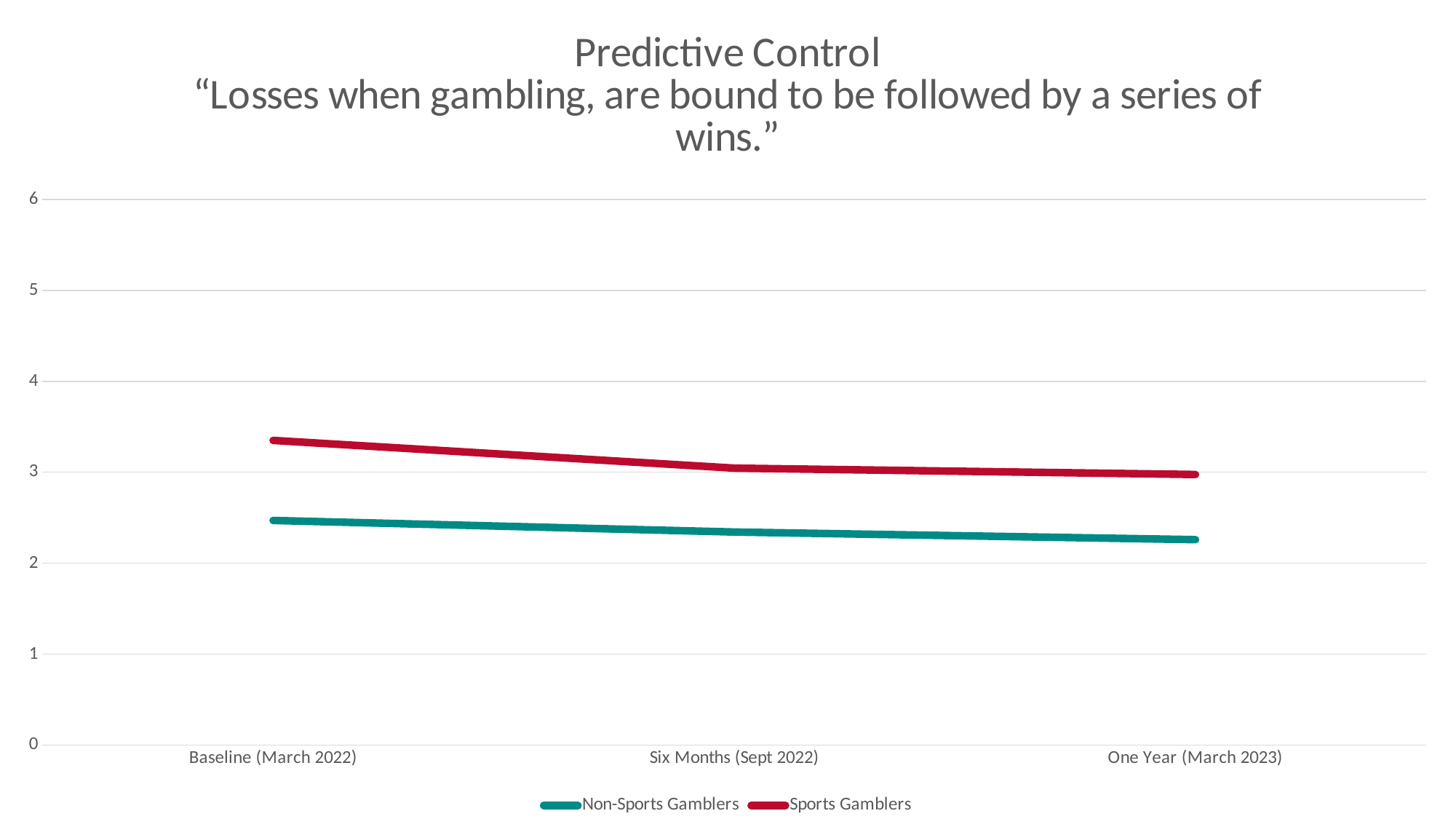
What colour is the line for Sports Gamblers? red Is the value for Sports Gamblers at Baseline (March 2022) greater or less than 3? greater Is the value for Non-Sports Gamblers at Baseline (March 2022) greater or less than 3? less Is the value for Non-Sports Gamblers at One Year (March 2023) greater or less than 2? greater How many time points are plotted along the x axis? 3 Which series is higher at One Year (March 2023): Non-Sports Gamblers or Sports Gamblers? Sports Gamblers How many series does the legend list? 2 Do the values for Sports Gamblers rise or fall from Baseline (March 2022) to One Year (March 2023)? fall Do the values for Non-Sports Gamblers rise or fall from Baseline (March 2022) to One Year (March 2023)? fall Which series is higher at Baseline (March 2022): Non-Sports Gamblers or Sports Gamblers? Sports Gamblers What kind of chart is shown on the slide? line chart At which time point is the Sports Gamblers value highest? Baseline (March 2022)